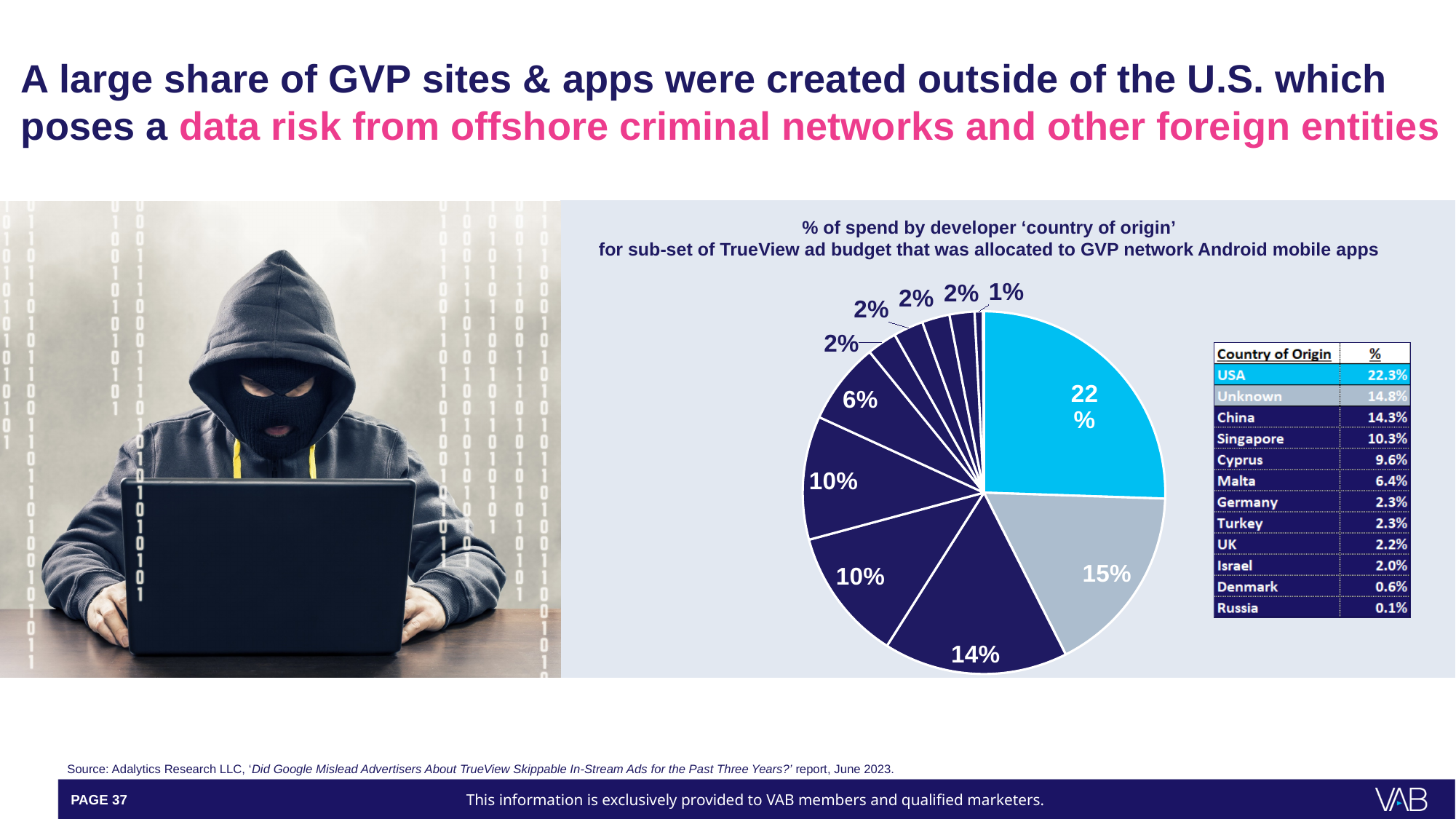
Which country of origin has the smallest percentage in the table? Russia Which has a larger share of spend, Cyprus or Malta? Cyprus What is the difference in percentage points between USA (22.3%) and Unknown (14.8%)? 7.5 percentage points What kind of chart is shown on the slide? Pie chart Which country of origin has the largest share of spend in the pie chart? USA According to the table, what is the percentage of spend for Singapore? 10.3% According to the table, what is the percentage of spend for China? 14.3% What is the title of the pie chart? % of spend by developer 'country of origin' for sub-set of TrueView ad budget that was allocated to GVP network Android mobile apps According to the table, what is the percentage of spend for Malta? 6.4% What colour is the USA slice in the pie chart? Light blue How many countries of origin are listed in the table? 12 What percentage label is shown on the largest slice of the pie chart? 22%